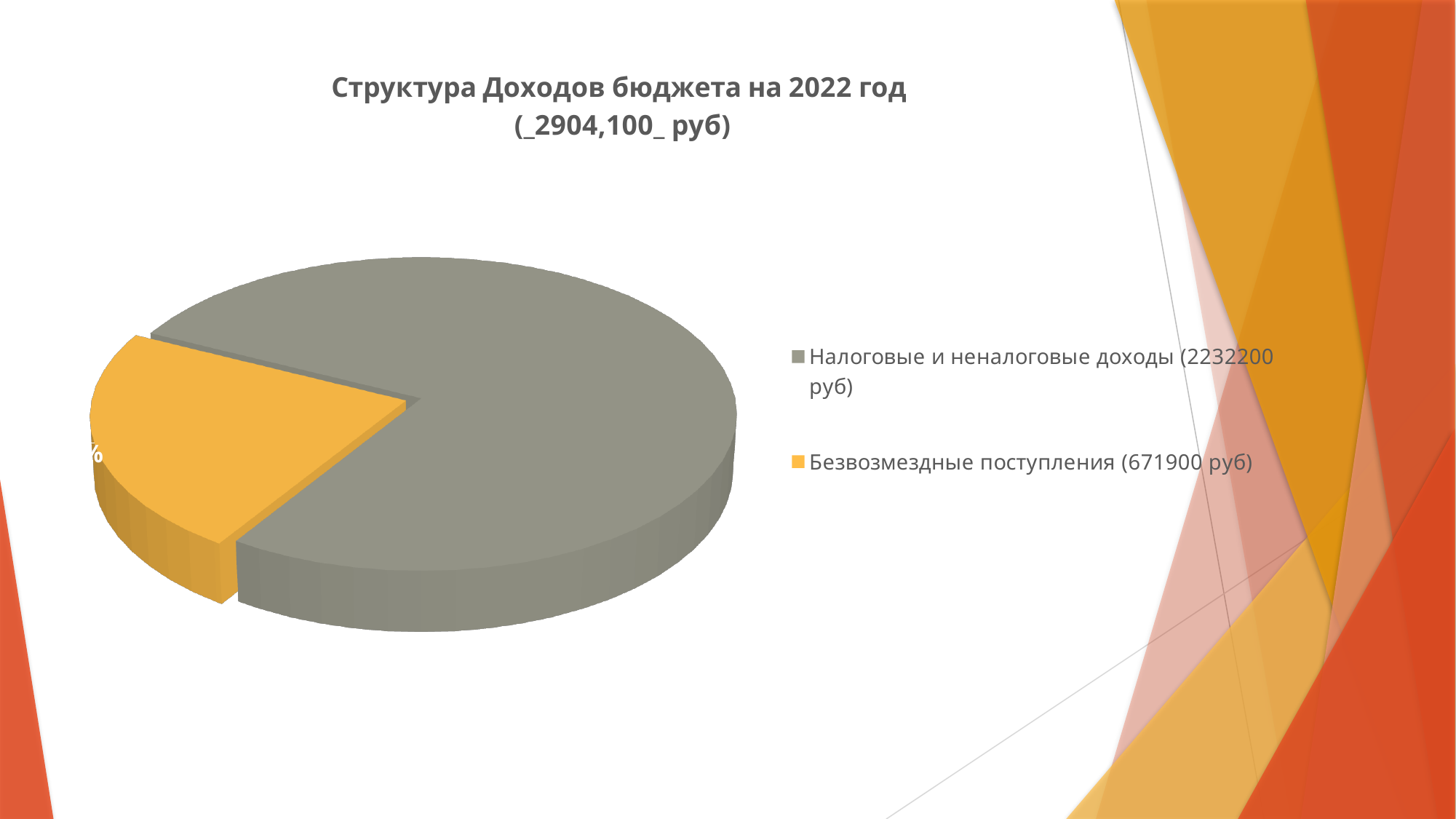
Which category has the largest slice of the pie? Налоговые и неналоговые доходы What value is given in the legend for Безвозмездные поступления? 671900 руб What value is given in the legend for Налоговые и неналоговые доходы? 2232200 руб What is the difference between Налоговые и неналоговые доходы and Безвозмездные поступления, in руб? 1560300 руб Which category has the smallest slice of the pie? Безвозмездные поступления What is the sum of the two values listed in the legend, in руб? 2904100 руб What colour is the slice for Безвозмездные поступления? Orange What is the title of the chart? Структура Доходов бюджета на 2022 год (_2904,100_ руб) How many entries does the legend list? 2 What kind of chart is shown on the slide? Pie chart Which is larger: Налоговые и неналоговые доходы or Безвозмездные поступления? Налоговые и неналоговые доходы How many slices does the pie chart have? 2